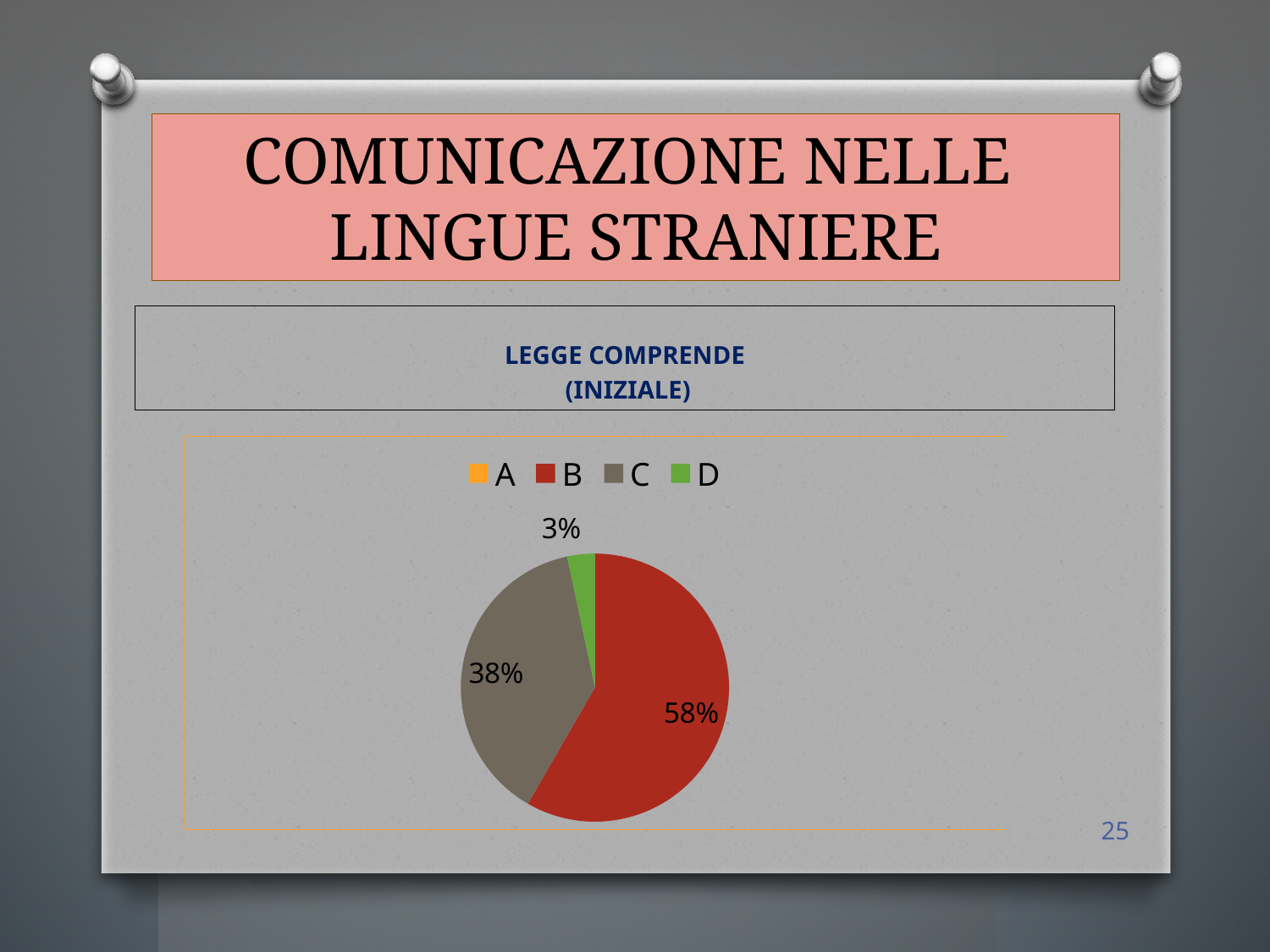
What colour is used for category B in the pie chart? Red Which category has the largest slice in the pie chart? B What percentage does slice B represent in the pie chart? 58% Which is larger, slice B or slice C? B What is the title of the chart on the slide? LEGGE COMPRENDE (INIZIALE) What is the difference in percentage points between slice B and slice C? 20 What percentage does slice D represent in the pie chart? 3% What is the difference in percentage points between slice C and slice D? 35 Which of the labelled slices (B, C, D) is the smallest in the pie chart? D How many categories does the legend of the pie chart list? 4 What percentage does slice C represent in the pie chart? 38% What kind of chart is shown on the slide? Pie chart